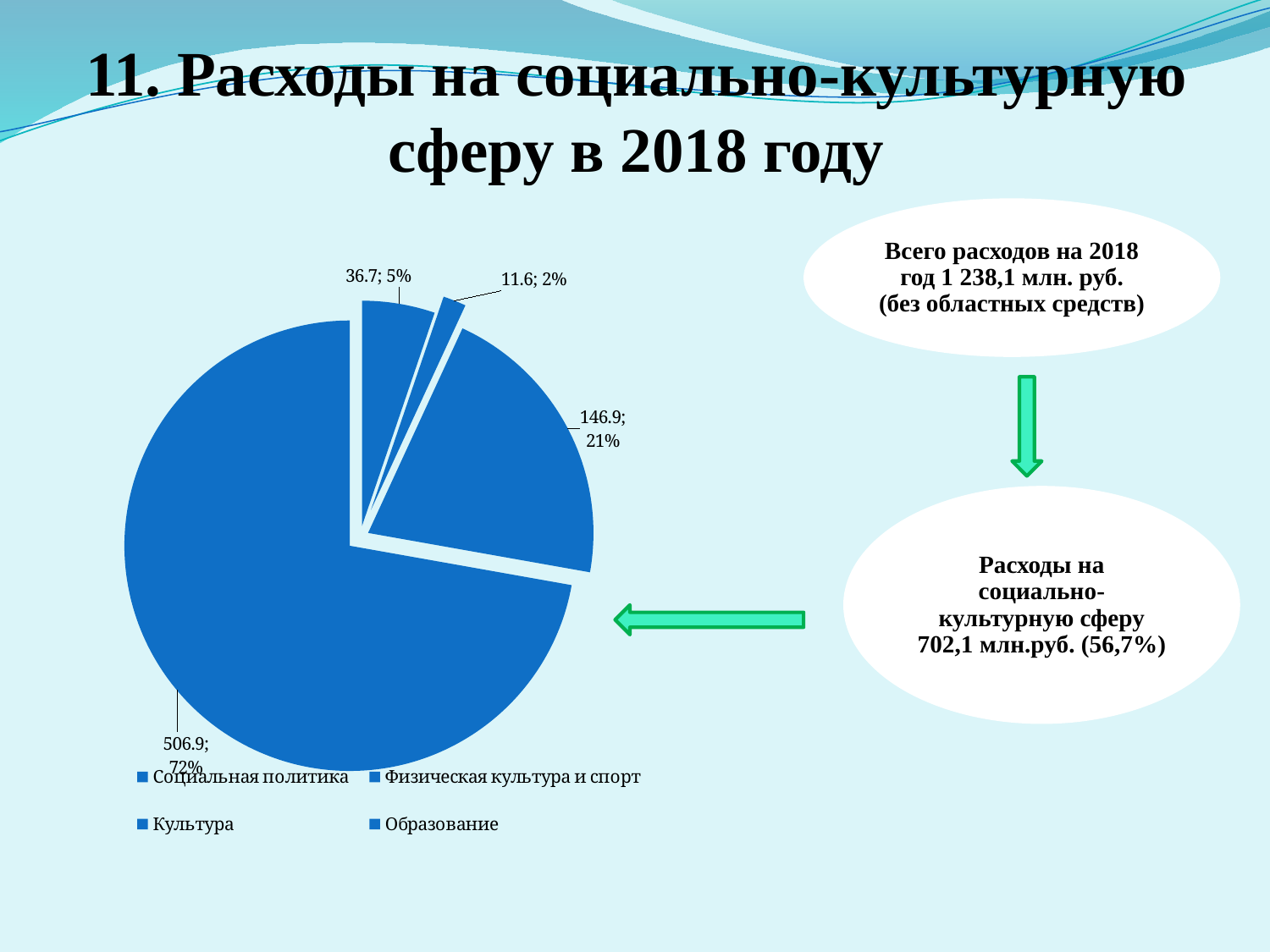
What share of the pie does the slice with value 146.9 represent? 21% What share of the pie does the largest slice (506.9) represent? 72% How many slices does the pie chart have? 4 What kind of chart is shown on the slide? pie chart What is the value of the smallest slice in the pie chart? 11.6 How many entries does the legend of the pie chart list? 4 What is the difference between the slice valued 506.9 and the slice valued 146.9? 360 What is the value of the largest slice in the pie chart? 506.9 What is the difference between the slice valued 36.7 and the slice valued 11.6? 25.1 Which is larger: the slice with 21% share or the slice with 5% share? the slice with 21% share (146.9) What is the value of the slice that represents 5% of the pie? 36.7 Which legend entries are listed for the pie chart? Социальная политика, Физическая культура и спорт, Культура, Образование